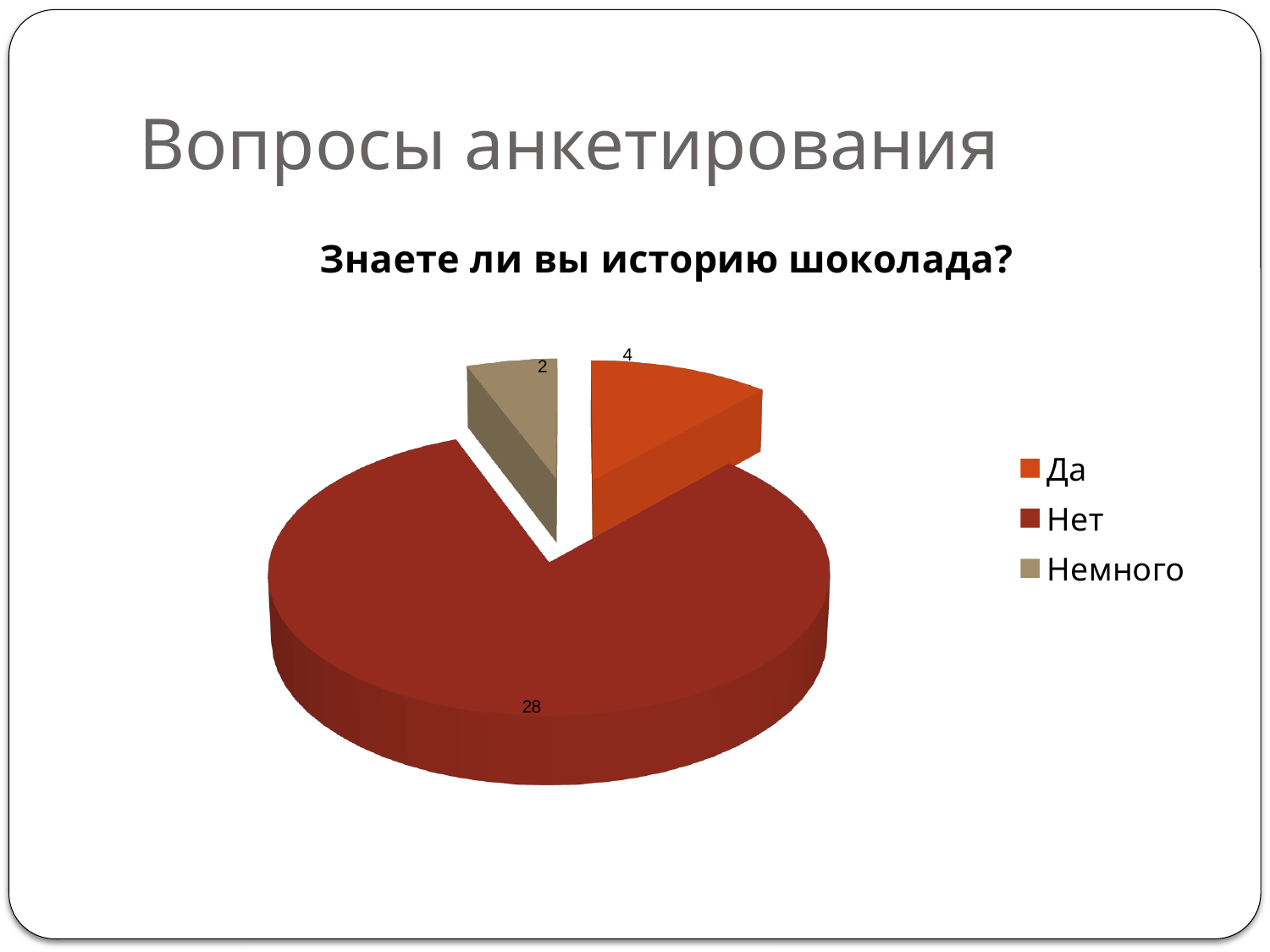
What is the value for "Нет"? 28 What is the difference between the values for "Нет" and "Да"? 24 What is the value for "Немного"? 2 What is the total of all slices in the pie chart? 34 What type of chart is shown on the slide? pie chart What is the value for "Да"? 4 What is the title of the chart? Знаете ли вы историю шоколада? How many categories does the pie chart have? 3 Which is larger, the value for "Да" or the value for "Немного"? Да Which category has the largest slice? Нет What colour is the slice for "Нет"? dark red Which category has the smallest slice? Немного